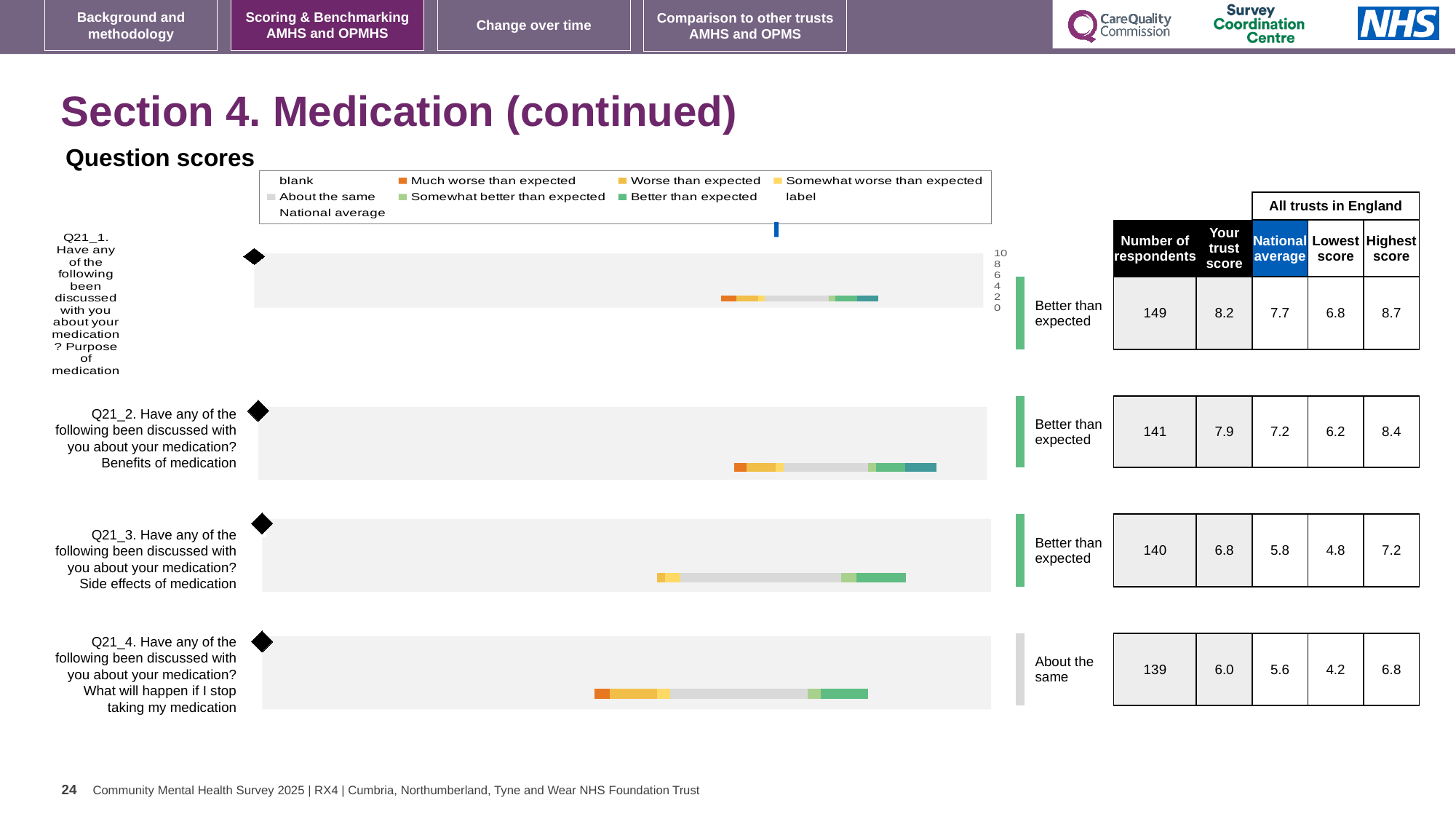
In the legend of the 'Question scores' chart, what colour represents 'Much worse than expected'? orange How many question bars are plotted in the 'Question scores' chart? 4 In the table beside the chart, which is larger: the highest score for Q21_3 or the highest score for Q21_4? Q21_3 According to the table beside the chart, which question has the lowest number of respondents? Q21_4 (What will happen if I stop taking my medication) In the table beside the chart, what is the difference between 'Your trust score' and the national average for Q21_2 (Benefits of medication)? 0.7 What is the heading printed above the chart? Question scores In the table beside the chart, what is the number of respondents for Q21_1 (Purpose of medication)? 149 How many entries does the legend of the 'Question scores' chart list? 9 According to the table beside the chart, which question has the highest 'Your trust score'? Q21_1 (Purpose of medication) In the table beside the chart, what is the national average for Q21_4 (What will happen if I stop taking my medication)? 5.6 What kind of chart is shown under the heading 'Question scores'? bar chart In the table beside the chart, what is 'Your trust score' for Q21_3 (Side effects of medication)? 6.8